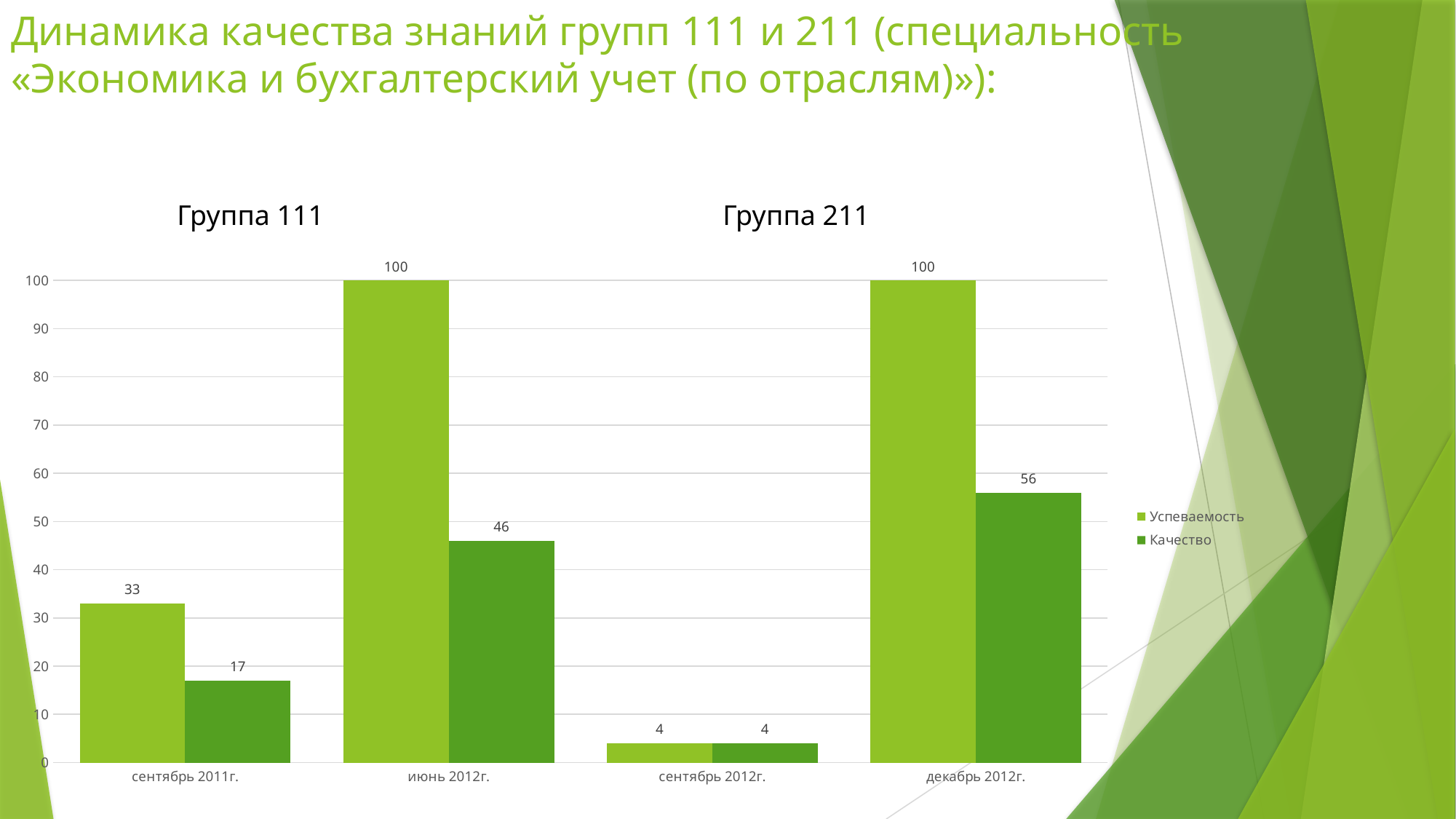
Which category has the highest value of Качество? декабрь 2012г. Which category has the lowest value of Качество? сентябрь 2012г. Which is larger: Качество for июнь 2012г. or Качество for декабрь 2012г.? декабрь 2012г. How many series does the legend list? 2 What is the value of Успеваемость for сентябрь 2012г.? 4 What is the difference between Успеваемость and Качество for июнь 2012г.? 54 What kind of chart is shown on the slide? bar chart What is the value of Успеваемость for сентябрь 2011г.? 33 What is the difference between Качество for декабрь 2012г. and Качество for сентябрь 2011г.? 39 What is the value of Качество for июнь 2012г.? 46 How many categories are shown on the x axis? 4 What is the value of Качество for декабрь 2012г.? 56